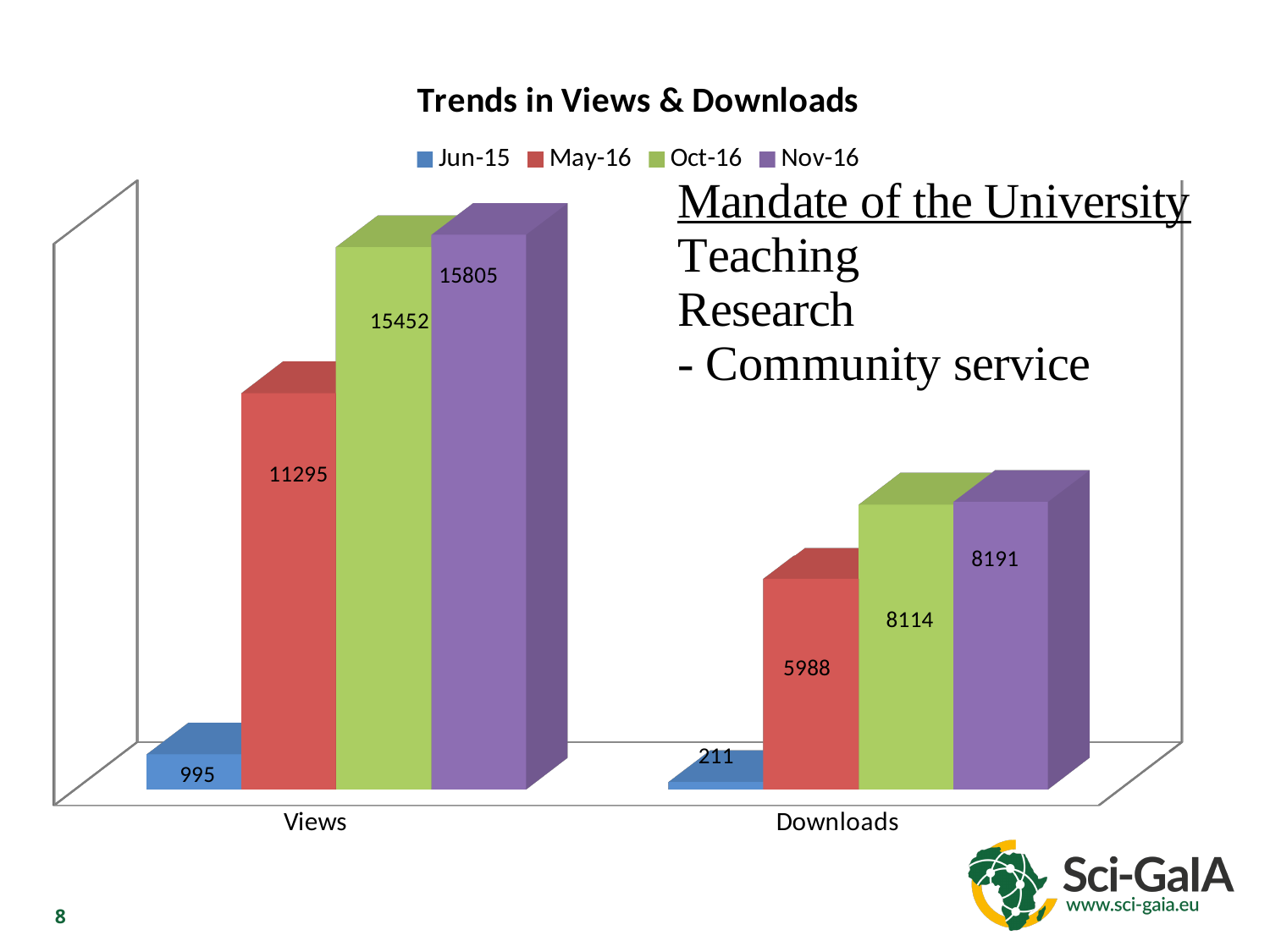
What is the title of the chart? Trends in Views & Downloads What kind of chart is shown? Bar chart What is the difference between Views in Oct-16 and Views in May-16? 4157 Which series has the highest value for Views? Nov-16 How many series does the legend list? 4 What is the value for Views in Jun-15? 995 What is the value for Downloads in Oct-16? 8114 Which series has the lowest value for Downloads? Jun-15 What is the difference between Downloads in Nov-16 and Downloads in Oct-16? 77 Which is larger: Views in May-16 or Downloads in Nov-16? Views in May-16 What is the value for Views in Nov-16? 15805 What is the value for Downloads in May-16? 5988